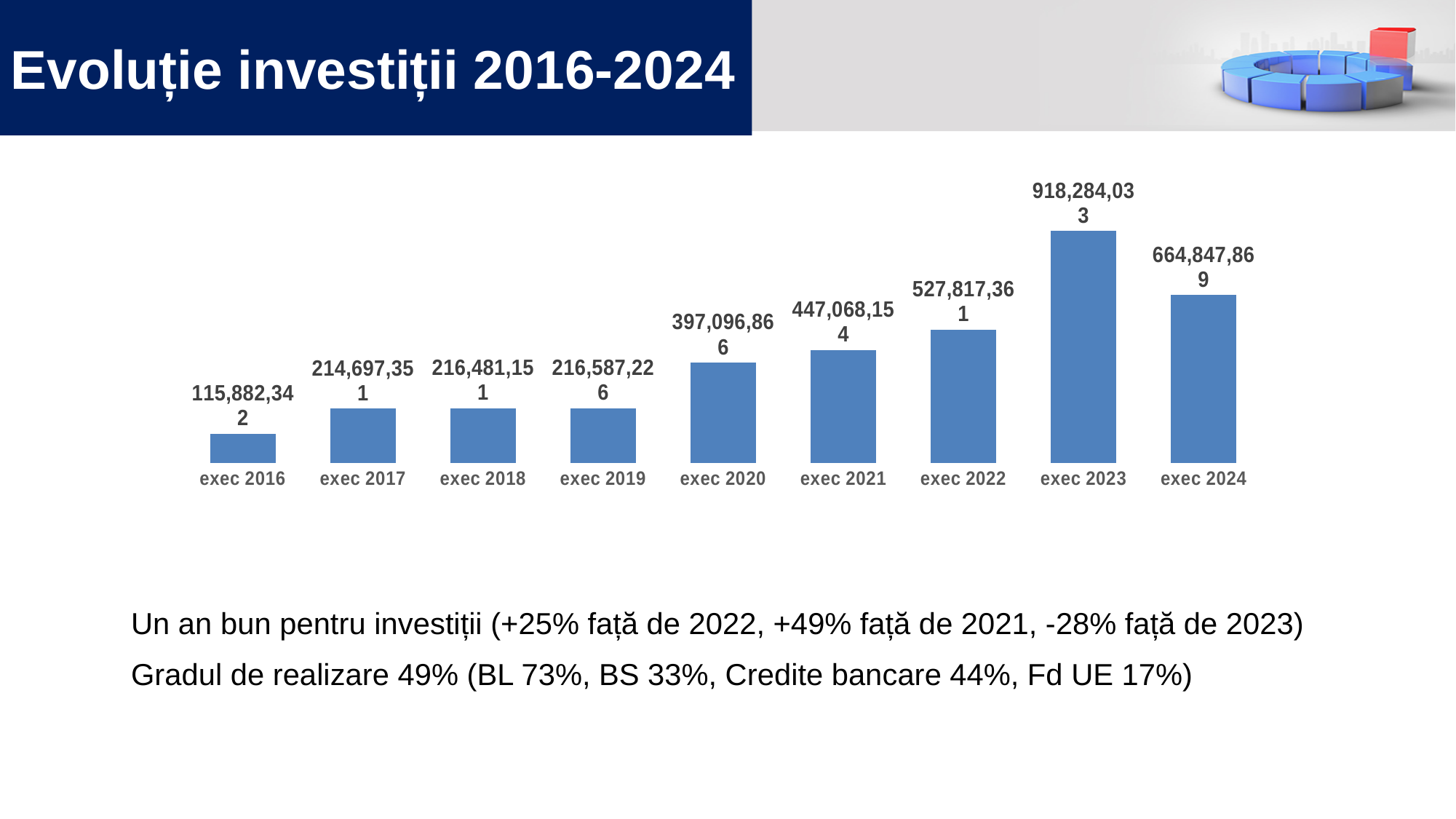
What is the difference between the values for exec 2023 and exec 2024? 253,436,164 What is the value for exec 2022? 527,817,361 What is the difference between the values for exec 2022 and exec 2021? 80,749,207 How many categories are shown on the chart? 9 Which category has the highest value? exec 2023 Do the values rise or fall from exec 2016 to exec 2023? rise What kind of chart is shown on the slide? bar chart What is the value for exec 2020? 397,096,866 What is the value for exec 2016? 115,882,342 What is the value for exec 2024? 664,847,869 Which category has the lowest value? exec 2016 Which is larger, the value for exec 2020 or the value for exec 2021? exec 2021